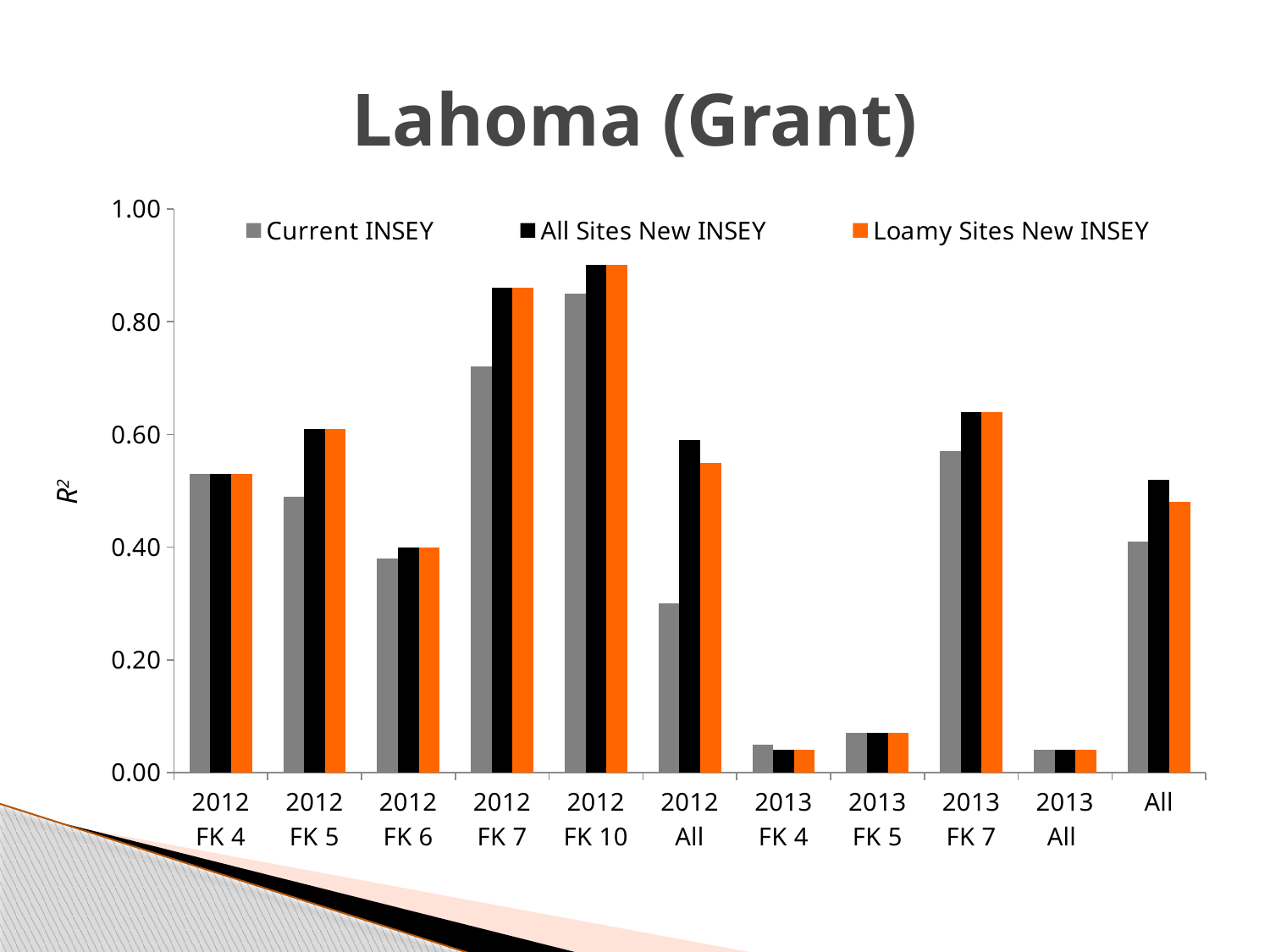
Which category has the highest All Sites New INSEY value? 2012 FK 10 For 2012 All, which is larger: All Sites New INSEY or Loamy Sites New INSEY? All Sites New INSEY What is the title of the chart? Lahoma (Grant) For 2012 FK 7, which is larger: Current INSEY or All Sites New INSEY? All Sites New INSEY Which category has the highest Current INSEY value? 2012 FK 10 Is the Current INSEY value for 2012 FK 10 greater or less than 0.80? greater Is the Current INSEY value for 2012 All greater or less than 0.40? less What kind of chart is shown on the slide? bar chart Is the All Sites New INSEY value for 2013 FK 7 greater or less than 0.60? greater How many series does the legend list? 3 How many categories are shown on the x axis? 11